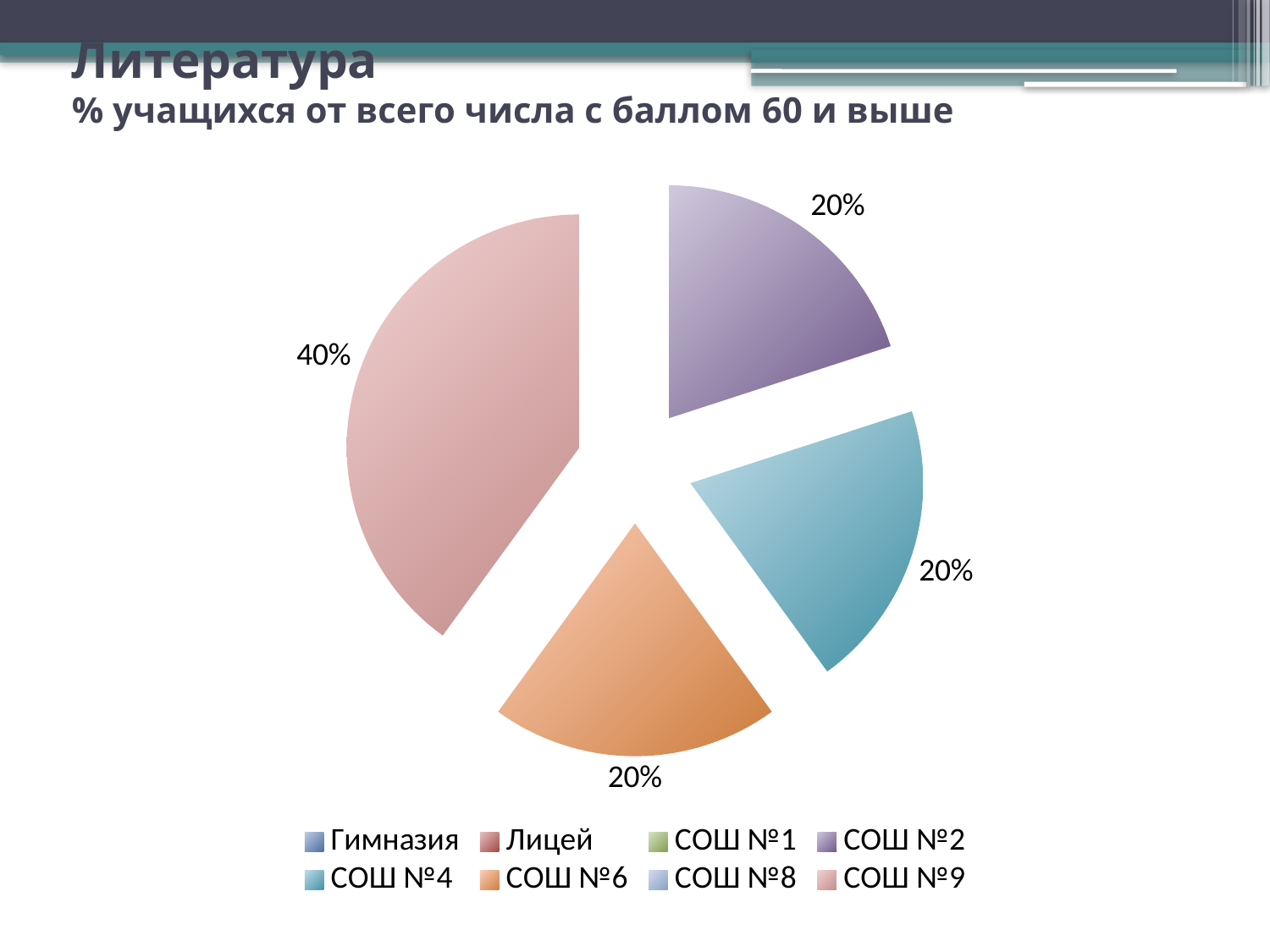
How many entries does the legend list? 8 How many slices are visible in the pie chart? 4 What is the value for СОШ №9? 40% Which school has the largest slice of the pie? СОШ №9 What is the title of the slide above the chart? Литература Which is larger, the slice for СОШ №9 or the slice for СОШ №6? СОШ №9 What is the value for СОШ №6? 20% What kind of chart is shown on the slide? pie chart What is the value for СОШ №4? 20% What is the value for СОШ №2? 20% What is the difference between the values for СОШ №9 and СОШ №4? 20% What colour is the slice for СОШ №6? orange